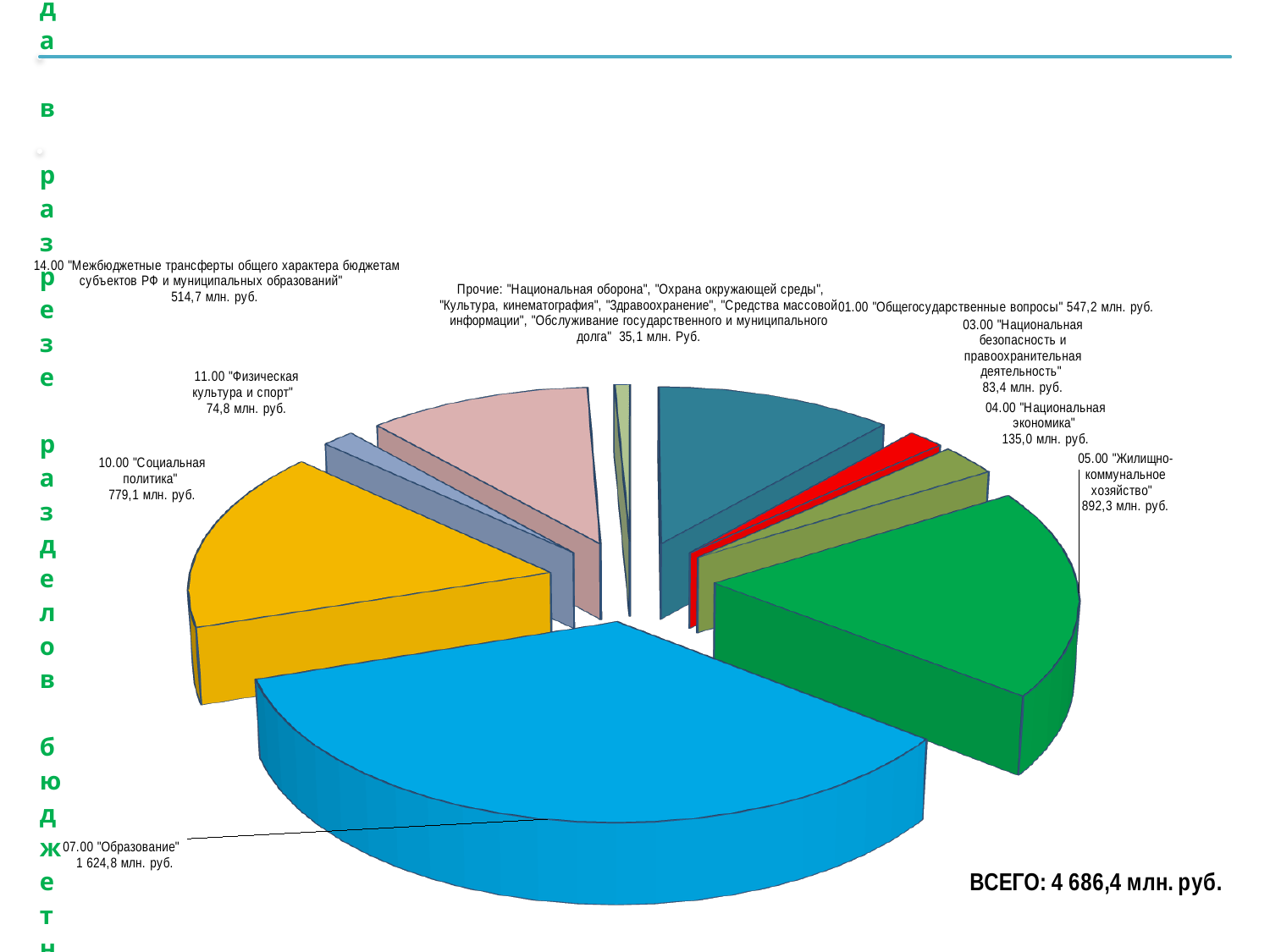
What is the value for 10.00 "Социальная политика"? 779,1 млн. руб. What share of the total does 07.00 "Образование" represent? 34,7% How many slices does the pie chart have? 9 Which slice of the pie is the smallest? Прочие (35,1 млн. руб.) What is the value for 07.00 "Образование"? 1 624,8 млн. руб. What is the difference between 07.00 "Образование" and 05.00 "Жилищно-коммунальное хозяйство"? 732,5 млн. руб. What is the value for 05.00 "Жилищно-коммунальное хозяйство"? 892,3 млн. руб. Which section has the largest slice of the pie? 07.00 "Образование" Which is larger: 01.00 "Общегосударственные вопросы" or 14.00 "Межбюджетные трансферты"? 01.00 "Общегосударственные вопросы" What is the value for 04.00 "Национальная экономика"? 135,0 млн. руб. What kind of chart is shown on the slide? Pie chart What is the total (ВСЕГО) shown on the slide? 4 686,4 млн. руб.